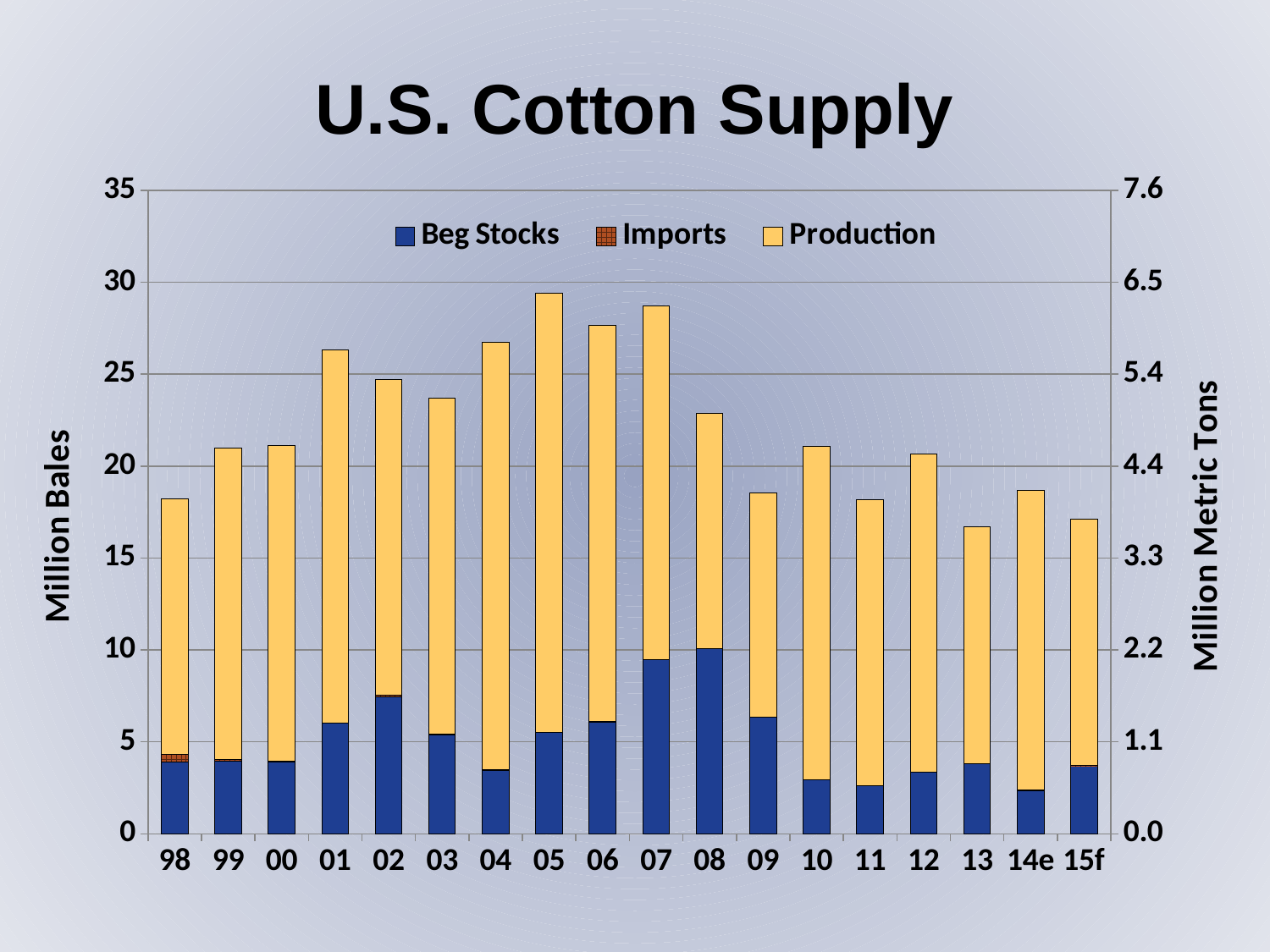
Which year has the taller total bar, 01 or 02? 01 How many series does the legend list? 3 Is the Beg Stocks value for 07 greater or less than 10 million bales? less Which year has the tallest total bar? 05 What kind of chart is shown on the slide? stacked bar chart Is the total bar for 05 greater or less than 25 million bales? greater Which year has the largest Beg Stocks segment? 08 What is the title of the left vertical axis? Million Bales Is the total bar for 13 greater or less than 20 million bales? less How many years are shown along the x axis? 18 Which year has the larger Beg Stocks segment, 02 or 03? 02